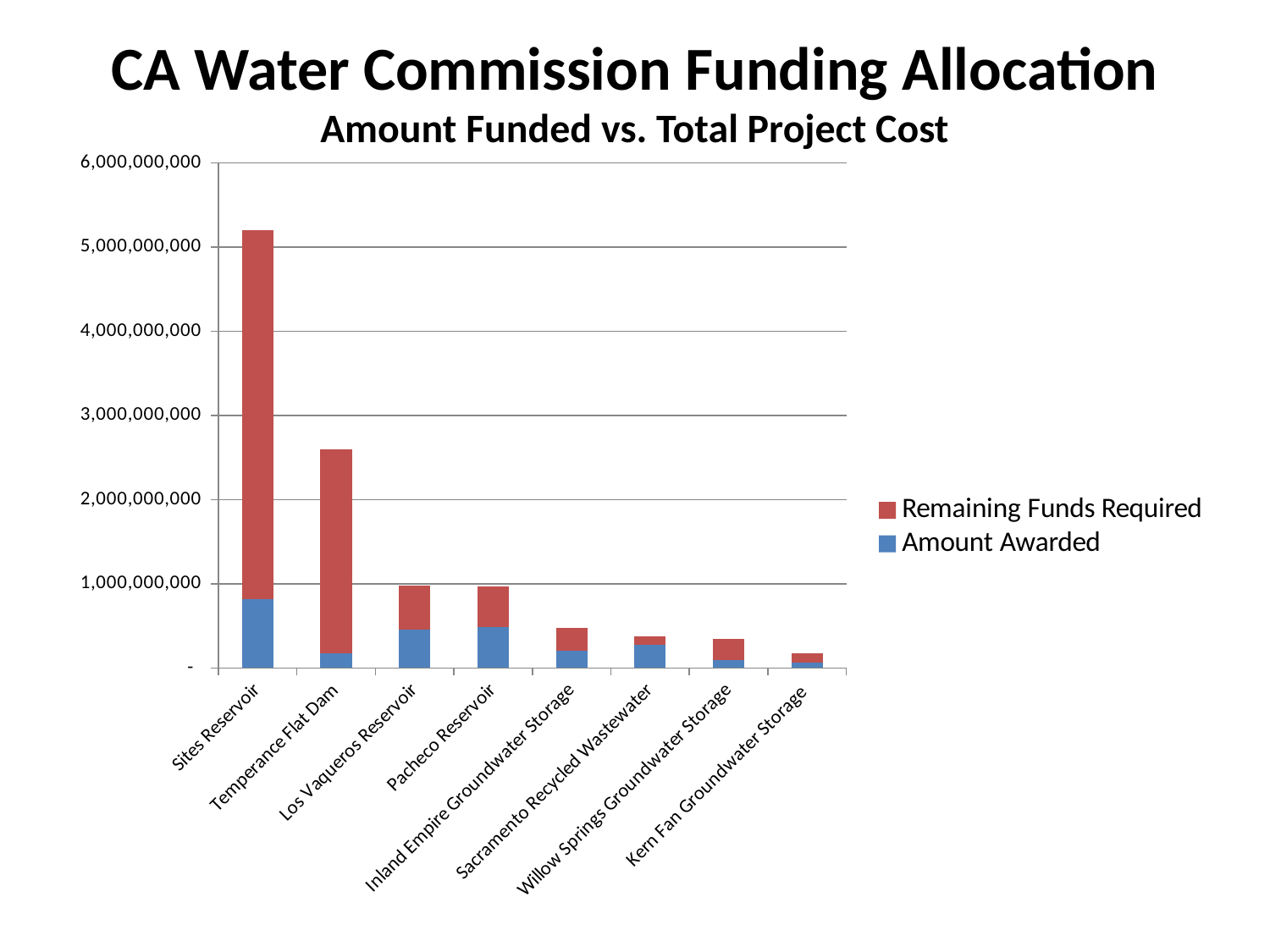
What kind of chart is shown on the slide? Stacked bar chart Is the total bar for Kern Fan Groundwater Storage greater or less than 1,000,000,000? less Is the total bar for Sites Reservoir greater or less than 5,000,000,000? greater How many series does the legend list? 2 Which has the larger total bar, Sites Reservoir or Temperance Flat Dam? Sites Reservoir Is the total bar for Temperance Flat Dam greater or less than 3,000,000,000? less Which series is shown in blue according to the legend? Amount Awarded Which project has the lowest total bar? Kern Fan Groundwater Storage Do the total bar heights rise or fall moving from left to right along the x axis? Fall How many projects (categories) are shown on the x axis? 8 Which project has the highest total bar? Sites Reservoir